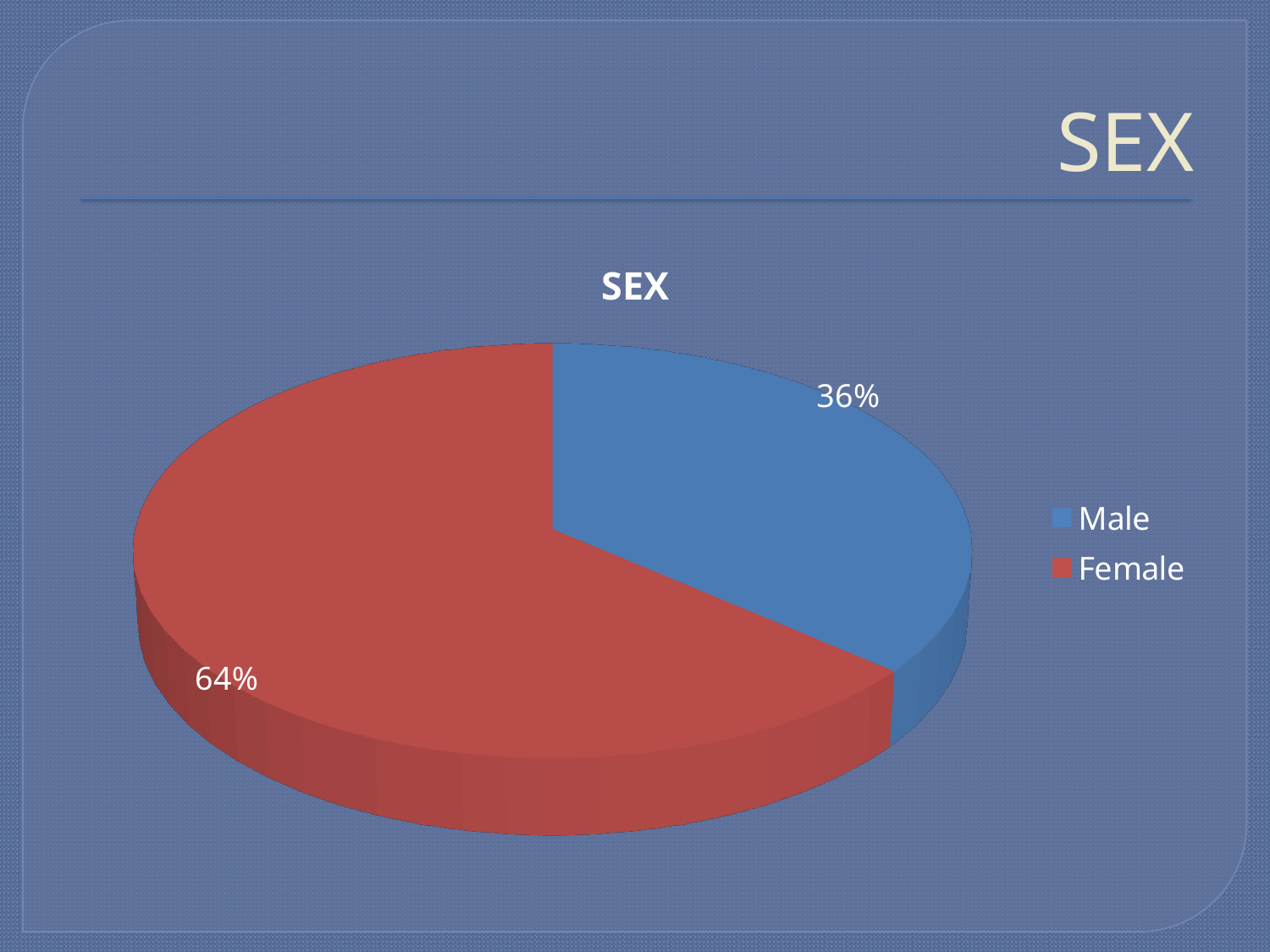
What is the combined share of the Male and Female slices? 100% What is the difference in percentage points between the Female and Male slices? 28 Which slice is larger, Male or Female? Female What is the title of the chart? SEX What kind of chart is shown on the slide? Pie chart Which category has the largest share of the pie? Female What percentage of the pie does the Male slice represent? 36% How many entries does the legend list? 2 Which category has the smallest share of the pie? Male What colour is the Female slice? Red What percentage of the pie does the Female slice represent? 64% How many slices does the pie chart have? 2